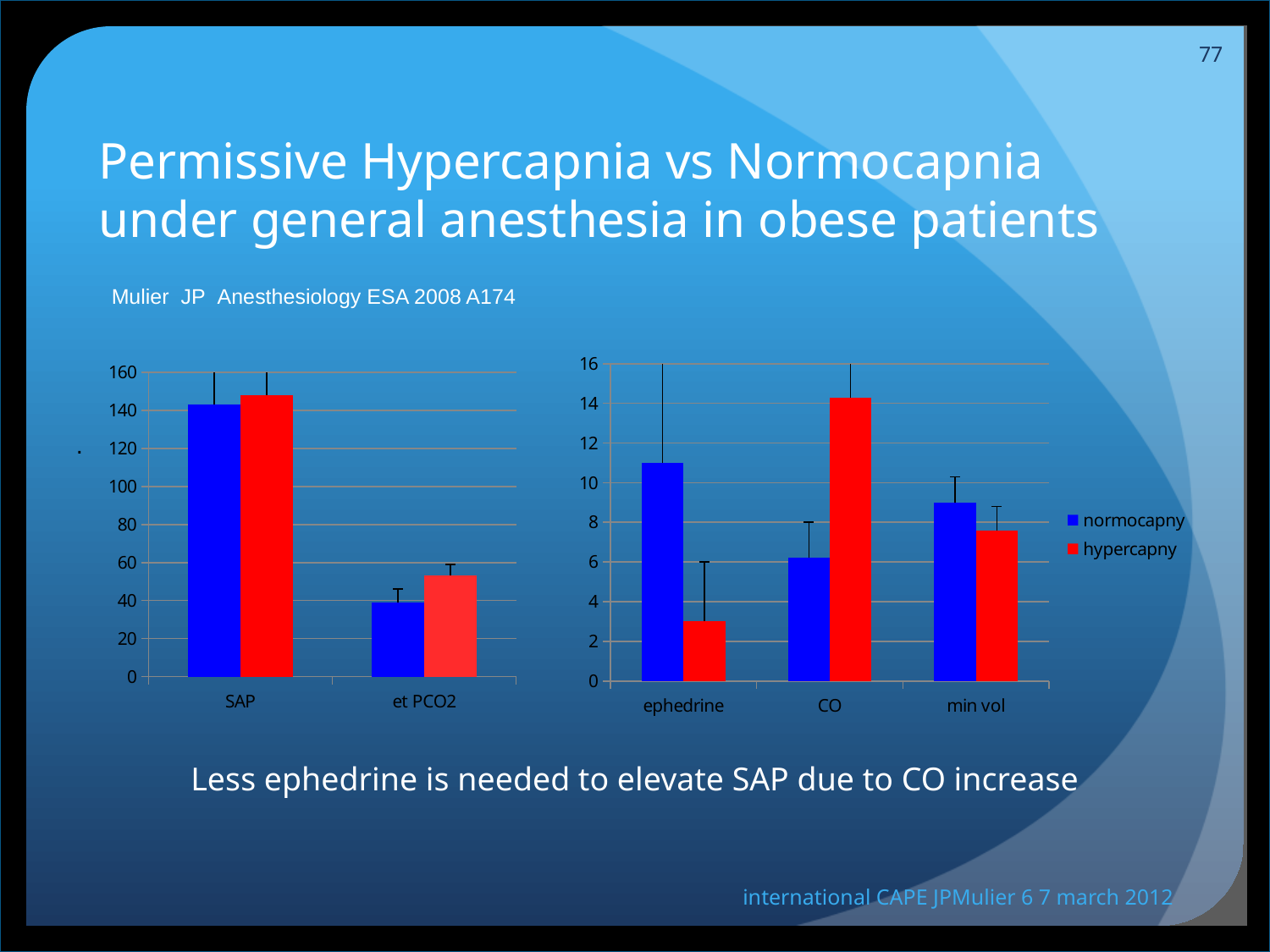
In the right chart, is the normocapny value for ephedrine greater or less than 10? greater In the left chart, which category has the lowest normocapny value? et PCO2 In the right chart, which series has the larger value for ephedrine, normocapny or hypercapny? normocapny How many series does the legend of the right chart list? 2 What colour represents the hypercapny series in the charts? red In the right chart, is the hypercapny value for ephedrine greater or less than 4? less How many categories are shown on the x axis of the left chart? 2 In the right chart, which series has the larger value for CO, normocapny or hypercapny? hypercapny How many categories are shown on the x axis of the right chart? 3 What kind of chart is the left chart on the slide? bar chart